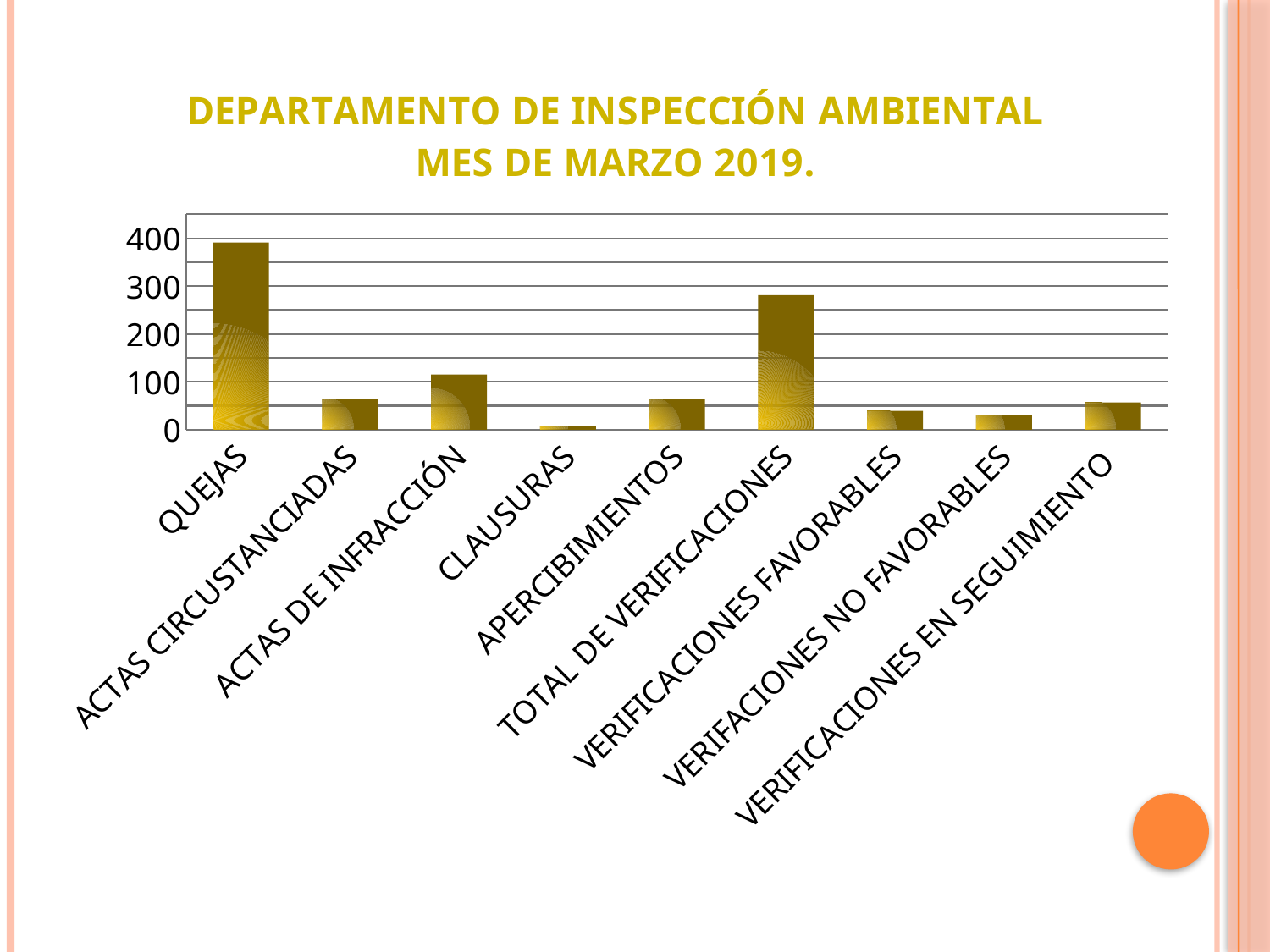
Is the value for ACTAS DE INFRACCIÓN greater or less than 100? greater Is the value for TOTAL DE VERIFICACIONES greater or less than 200? greater What is the title shown above the chart? DEPARTAMENTO DE INSPECCIÓN AMBIENTAL MES DE MARZO 2019. What type of chart is shown on the slide? bar chart Which is larger, QUEJAS or TOTAL DE VERIFICACIONES? QUEJAS Is the value for QUEJAS greater or less than 300? greater How many categories are plotted on the chart? 9 Which category has the highest value? QUEJAS Which is larger, ACTAS DE INFRACCIÓN or APERCIBIMIENTOS? ACTAS DE INFRACCIÓN Which category has the lowest value? CLAUSURAS Which is larger, VERIFICACIONES FAVORABLES or TOTAL DE VERIFICACIONES? TOTAL DE VERIFICACIONES